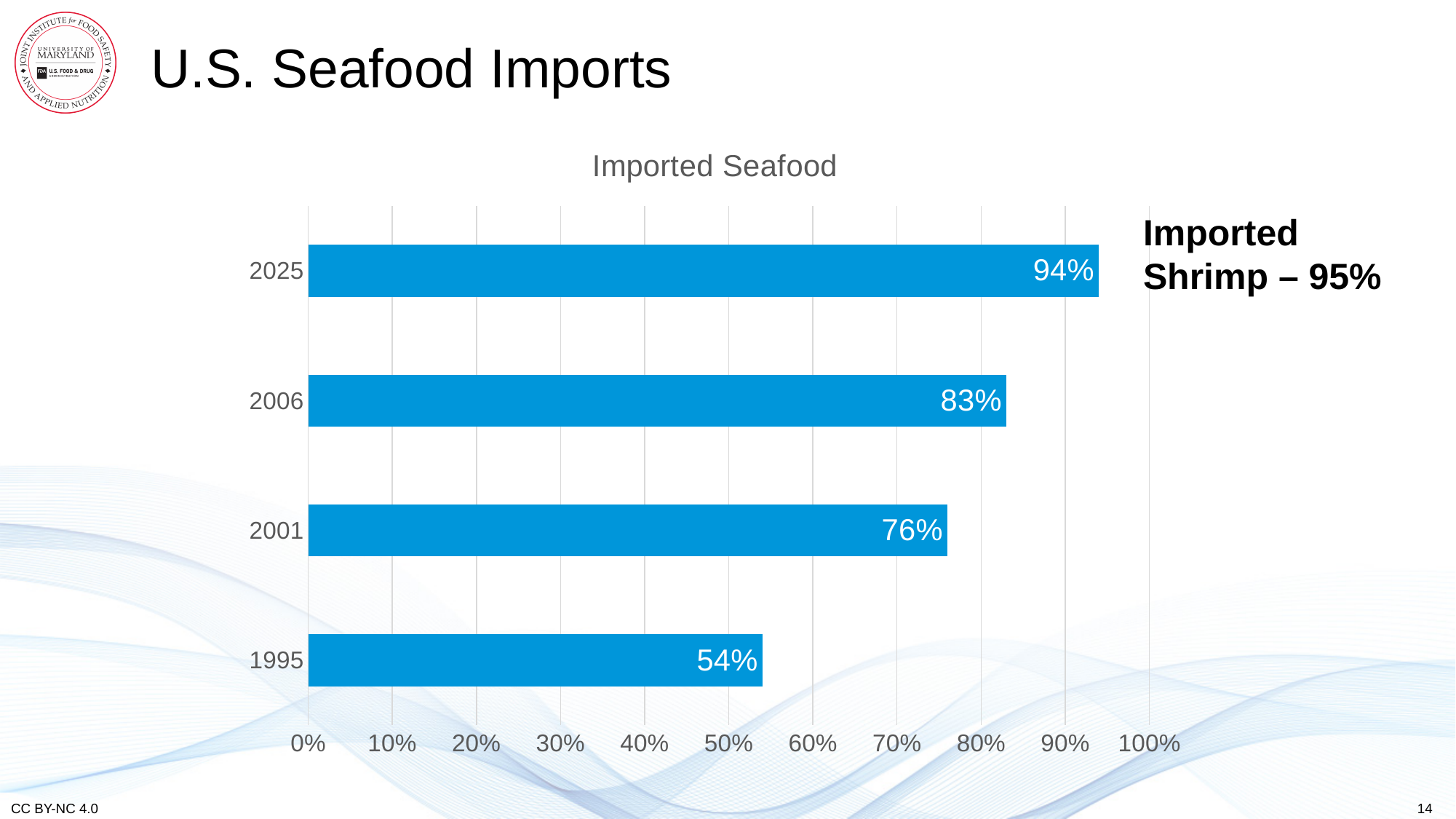
What is the difference between the values for 2025 and 1995? 40% What is the value for 2025 in the Imported Seafood chart? 94% What kind of chart is shown on the slide? Bar chart Which is larger, the value for 2001 or the value for 2006? 2006 How many years are shown in the Imported Seafood chart? 4 What is the title of the chart? Imported Seafood What is the difference between the values for 2006 and 2001? 7% Which year has the highest value in the Imported Seafood chart? 2025 Is the value for 2001 greater or less than 70%? greater What is the value for 1995 in the Imported Seafood chart? 54% Which year has the lowest value in the Imported Seafood chart? 1995 What is the value for 2006 in the Imported Seafood chart? 83%